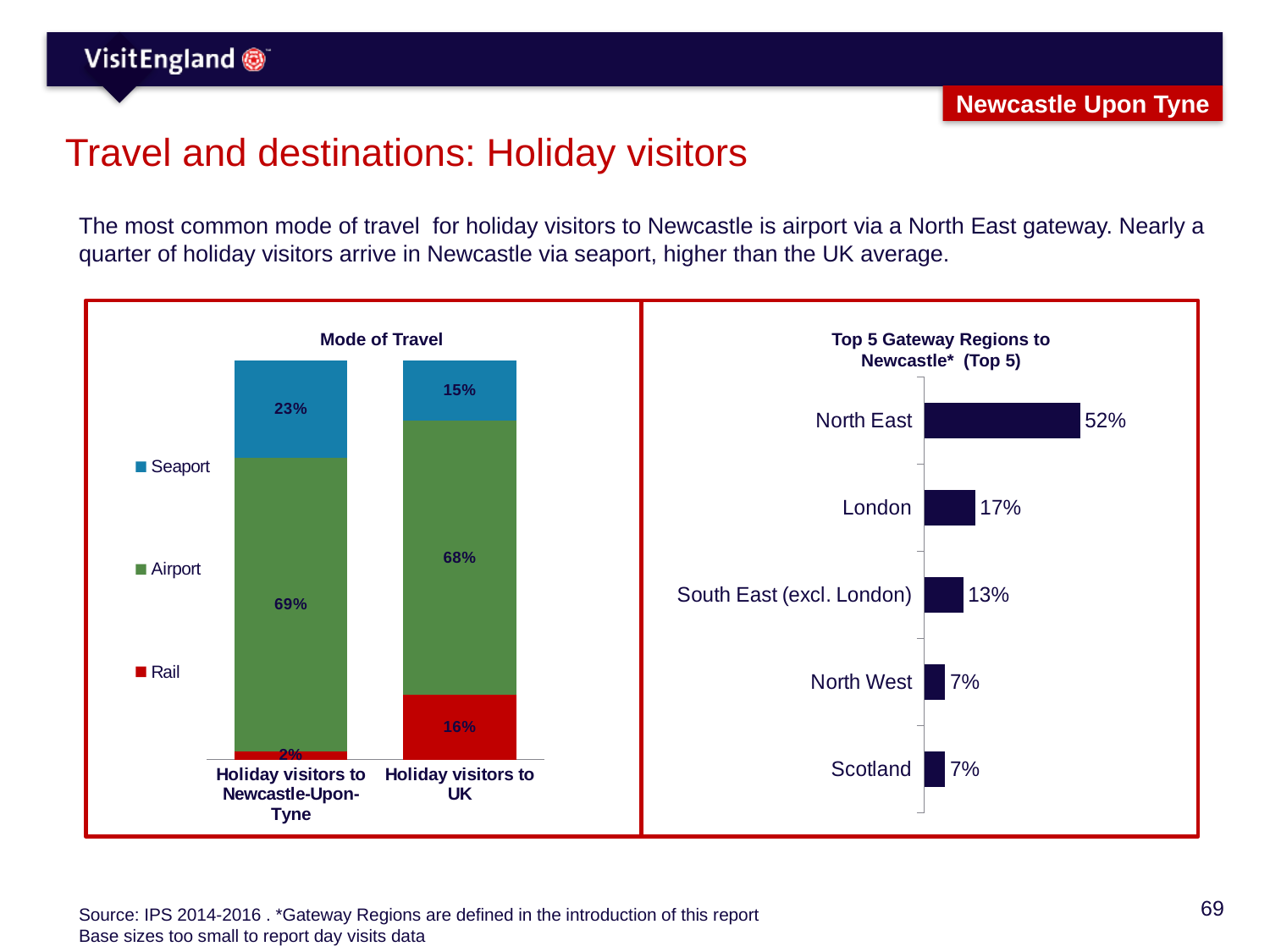
In the Top 5 Gateway Regions to Newcastle chart, what is the value for South East (excl. London)? 13% In the Mode of Travel chart, which is larger: the rail share for holiday visitors to Newcastle-Upon-Tyne or for holiday visitors to the UK? Holiday visitors to UK In the Mode of Travel chart, what is the difference between the seaport share for holiday visitors to Newcastle-Upon-Tyne and for holiday visitors to the UK? 8 percentage points In the Mode of Travel chart, what percentage of holiday visitors to the UK arrive by rail? 16% In the Mode of Travel chart, what percentage of holiday visitors to Newcastle-Upon-Tyne arrive by seaport? 23% In the Top 5 Gateway Regions to Newcastle chart, what is the difference between the values for North East and London? 35 percentage points In the Mode of Travel chart, what percentage of holiday visitors to Newcastle-Upon-Tyne arrive by airport? 69% What kind of chart is the Mode of Travel chart? Stacked bar chart In the Top 5 Gateway Regions to Newcastle chart, which region has the highest value? North East In the Top 5 Gateway Regions to Newcastle chart, what is the value for London? 17% In the Mode of Travel chart, how many series does the legend list? 3 In the Top 5 Gateway Regions to Newcastle chart, how many regions are shown? 5